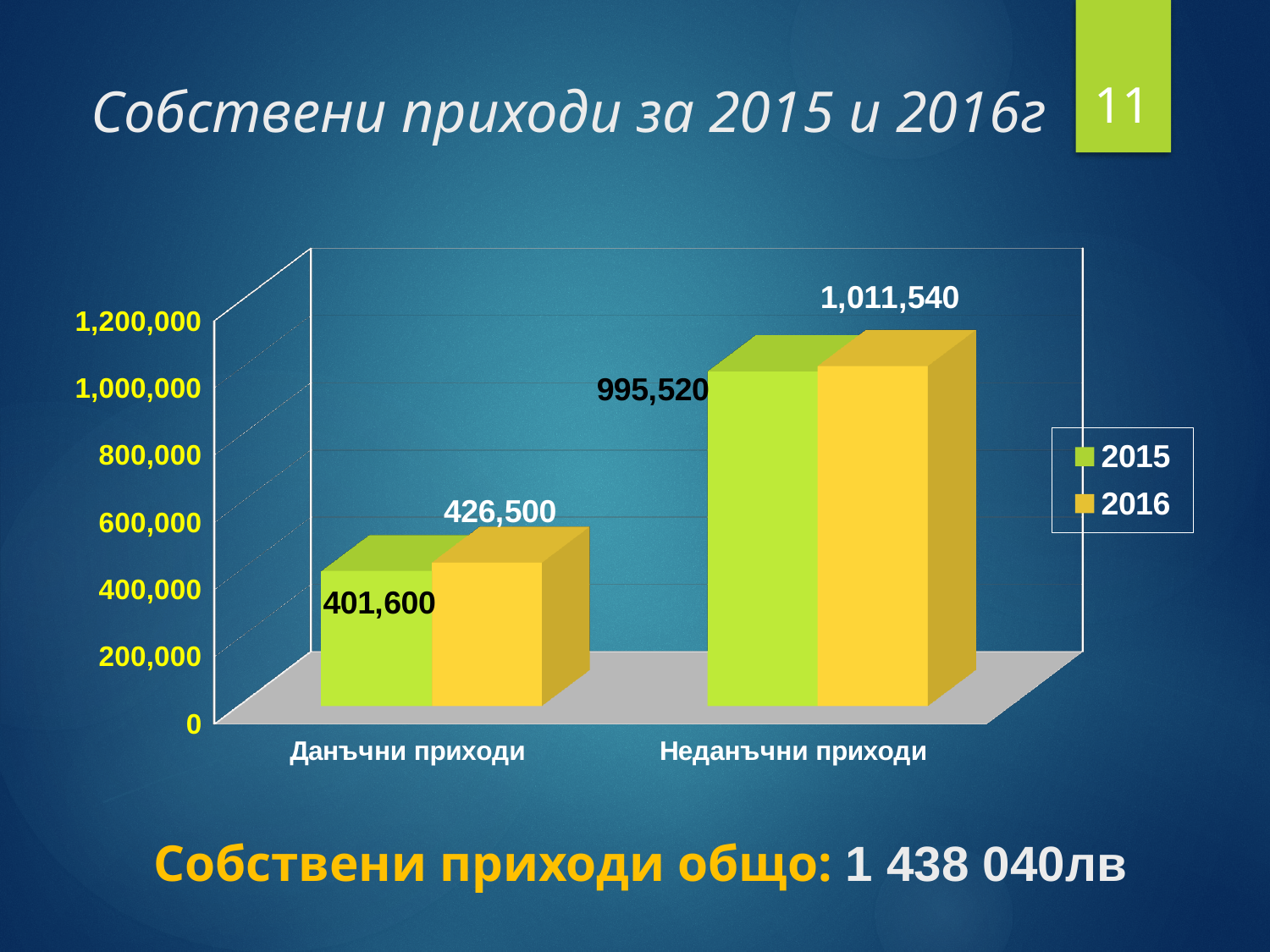
What is the difference between the 2016 and 2015 values for Данъчни приходи? 24,900 Which category has the lowest value in 2015? Данъчни приходи What is the value for Данъчни приходи in 2016? 426,500 What is the difference between the 2016 and 2015 values for Неданъчни приходи? 16,020 Which is larger: Неданъчни приходи in 2015 or Данъчни приходи in 2016? Неданъчни приходи in 2015 What is the value for Неданъчни приходи in 2016? 1,011,540 How many categories are shown on the x axis? 2 What is the value for Данъчни приходи in 2015? 401,600 What is the value for Неданъчни приходи in 2015? 995,520 How many series does the legend list? 2 What kind of chart is shown on the slide? Bar chart Which category has the highest value in 2016? Неданъчни приходи